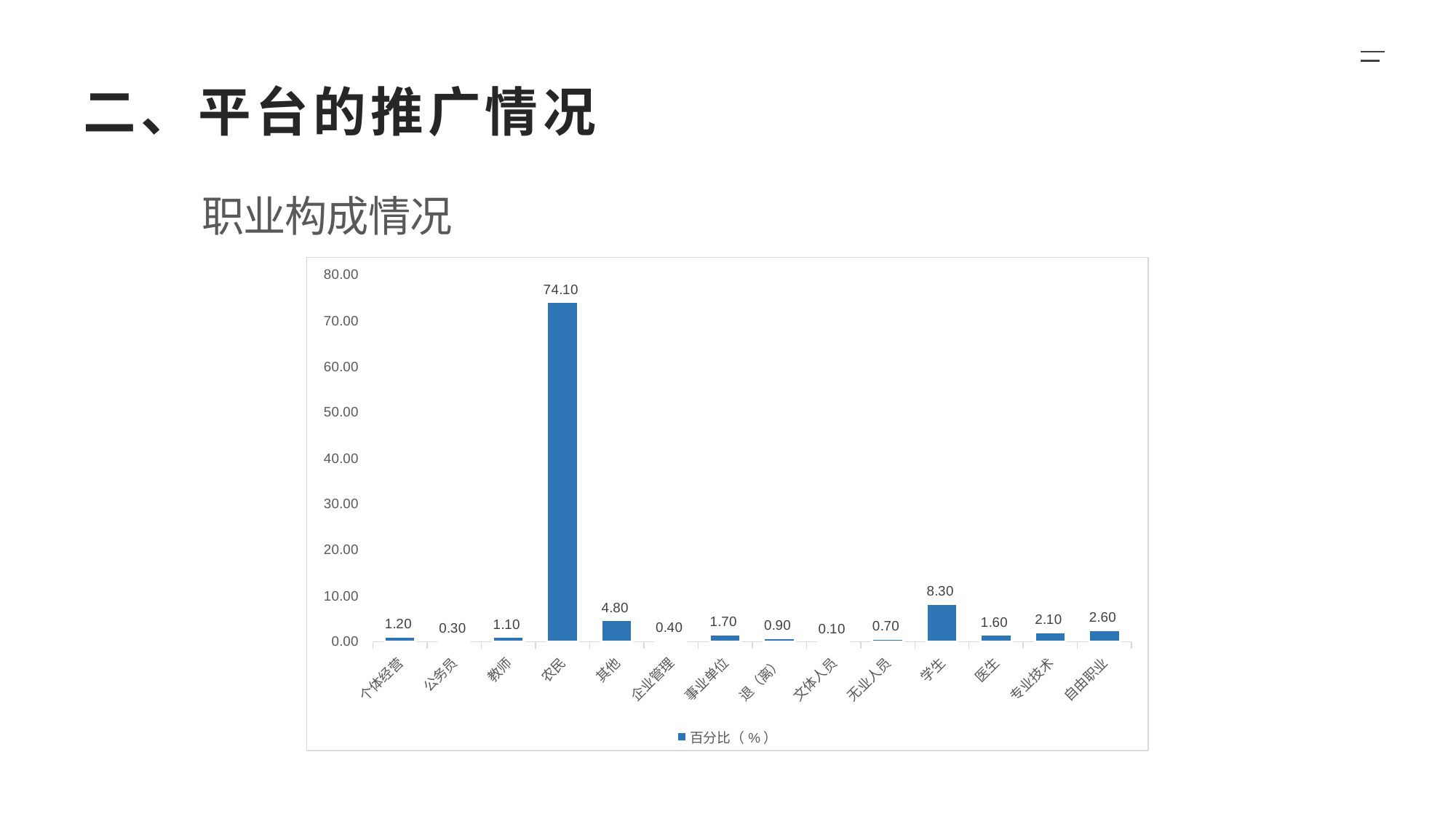
Which is larger, the value for 医生 or the value for 教师? 医生 Which category has the lowest value? 文体人员 What is the difference between the values for 其他 and 专业技术? 2.70 What kind of chart is shown on the slide? bar chart How many categories are shown on the x axis? 14 What is the value for 学生? 8.30 What series name does the legend show? 百分比（%） What is the value for 自由职业? 2.60 What is the difference between the values for 农民 and 学生? 65.80 Which category has the highest value? 农民 What is the value for 农民? 74.10 Is the value for 农民 greater or less than 70.00? greater